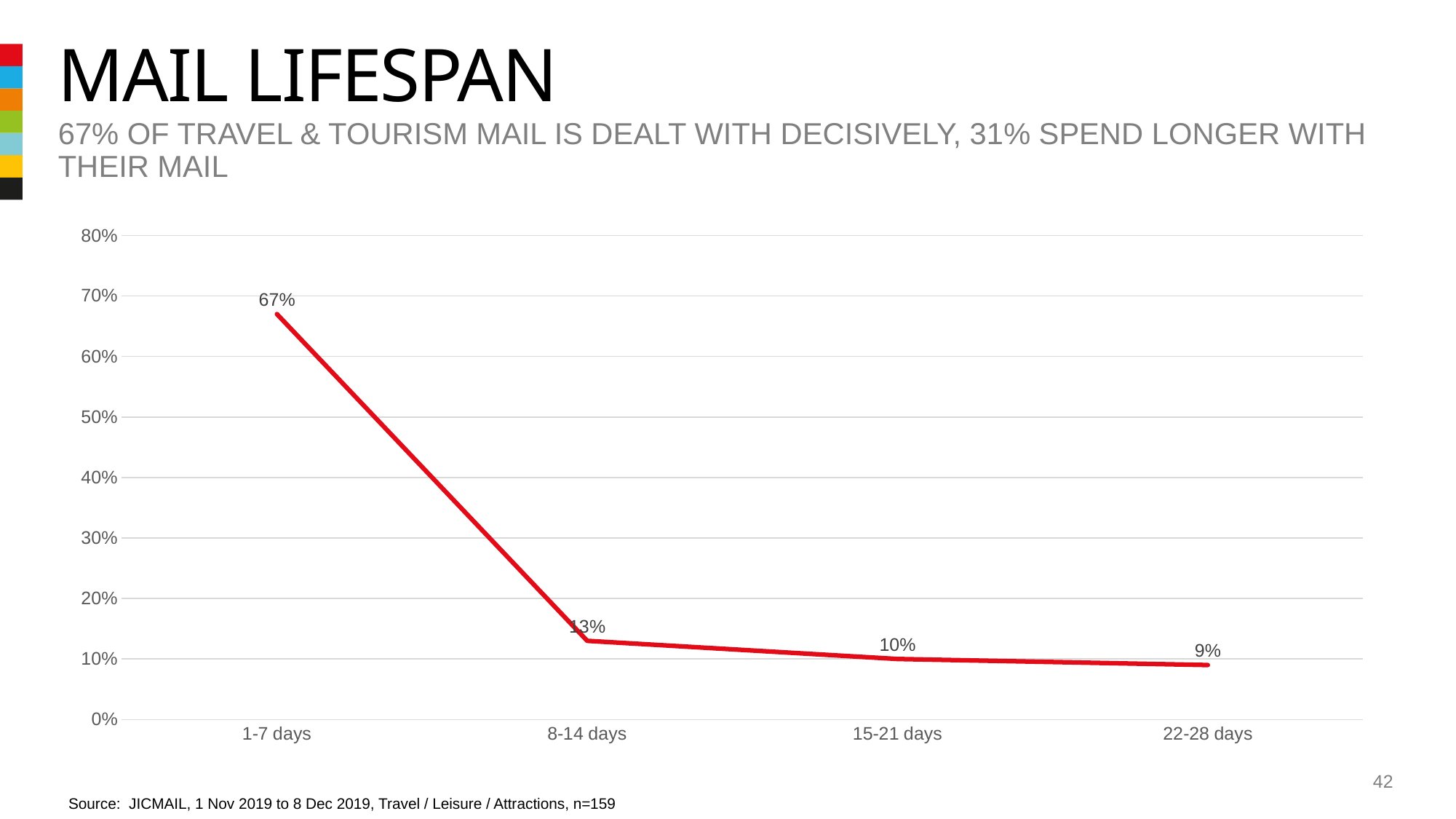
What is the value for 15-21 days? 10% Which is larger, the value for 8-14 days or the value for 15-21 days? 8-14 days Which category has the lowest value? 22-28 days What is the value for 8-14 days? 13% How many categories are shown on the x axis? 4 Which category has the highest value? 1-7 days What is the value for 1-7 days? 67% Do the values rise or fall from 1-7 days to 22-28 days? fall What is the value for 22-28 days? 9% What is the difference between the values for 1-7 days and 8-14 days? 54% What kind of chart is shown on the slide? line chart Is the value for 1-7 days greater or less than 60%? greater